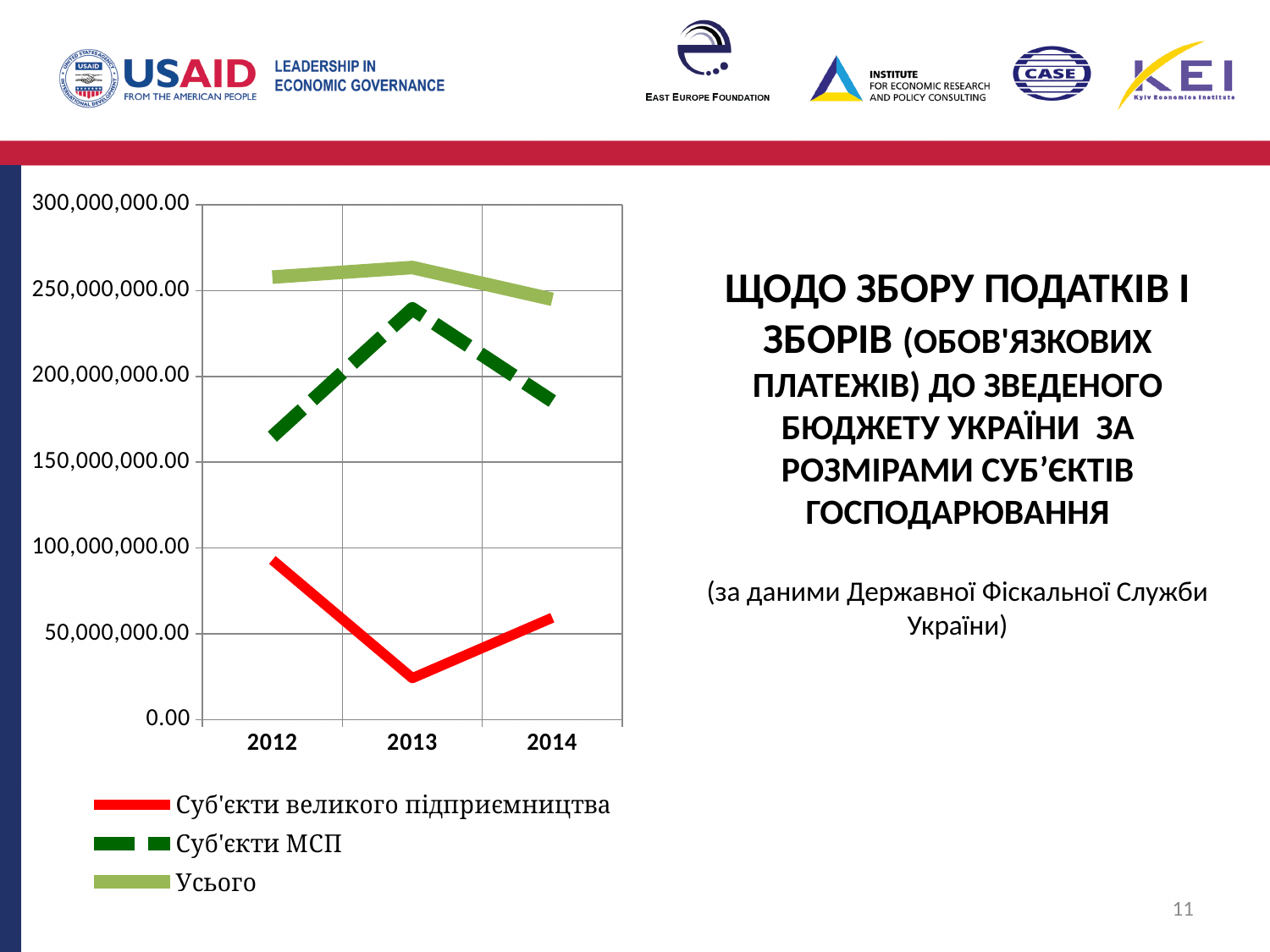
Which series in the legend is drawn with a dashed line? Суб'єкти МСП Which series has the larger value in 2012, Суб'єкти великого підприємництва or Суб'єкти МСП? Суб'єкти МСП How many years are shown on the x axis of the chart? 3 What kind of chart is shown on the slide? line chart Does the value for Суб'єкти великого підприємництва rise or fall from 2012 to 2013? fall How many series does the chart legend list? 3 In which year is the value for Суб'єкти великого підприємництва lowest? 2013 Is the value for Суб'єкти великого підприємництва in 2013 greater or less than 50,000,000.00? less Is the value for Усього in 2014 greater or less than 200,000,000.00? greater Is the value for Суб'єкти великого підприємництва in 2012 greater or less than 50,000,000.00? greater In which year is the value for Суб'єкти МСП highest? 2013